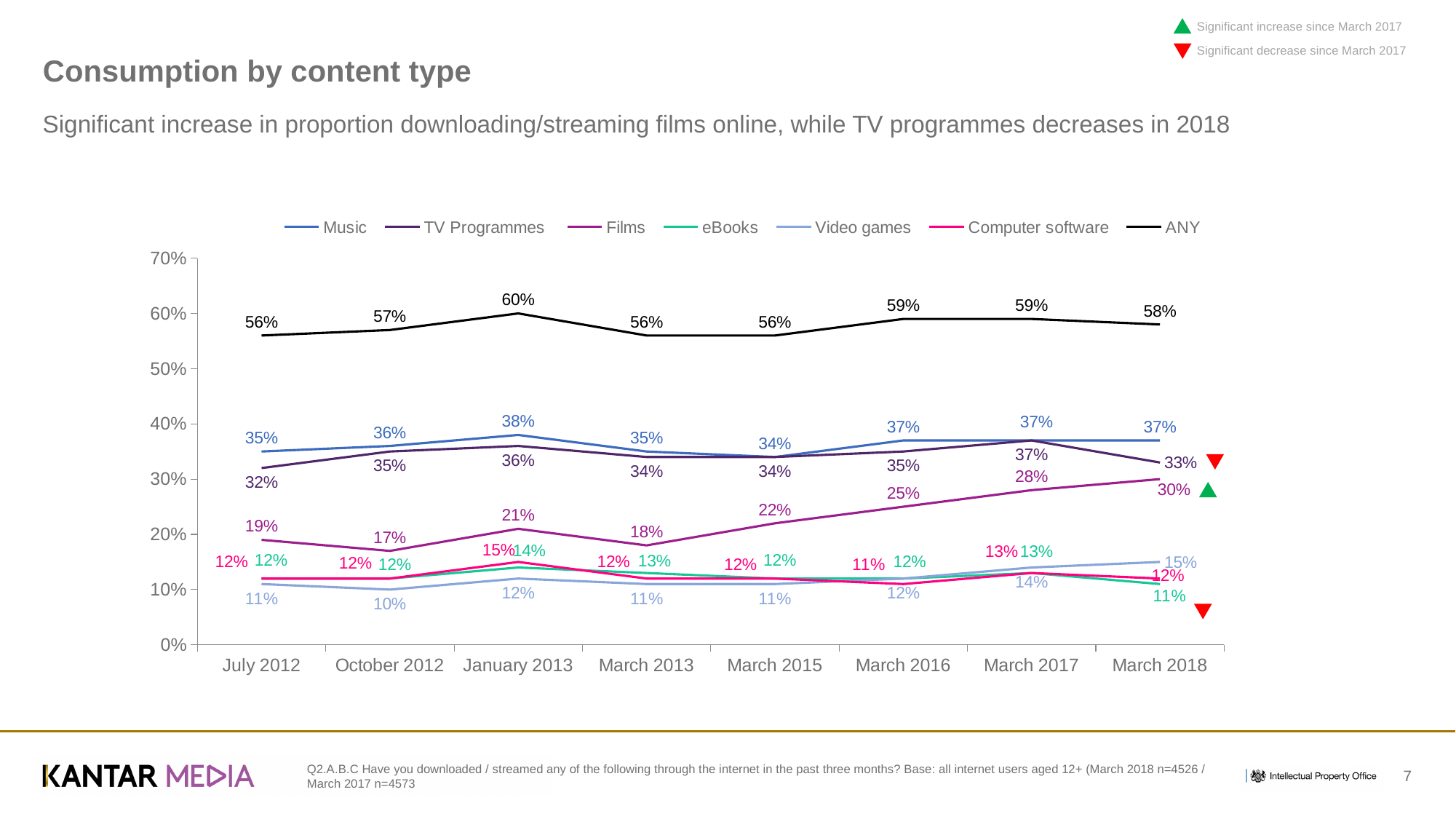
What kind of chart is shown on the slide? line chart In which period is the Video games series at its lowest? October 2012 Which series is drawn in black? ANY What is the difference between Music and TV Programmes in March 2018? 4 percentage points What is the value for ANY in January 2013? 60% In which period is the ANY series at its highest? January 2013 How many time points are shown along the x axis? 8 What is the value for Films in March 2018? 30% What is the value for TV Programmes in July 2012? 32% How many series does the legend list? 7 Does the Films series rise or fall from March 2013 to March 2018? rise In March 2018, which is larger: Films or TV Programmes? TV Programmes